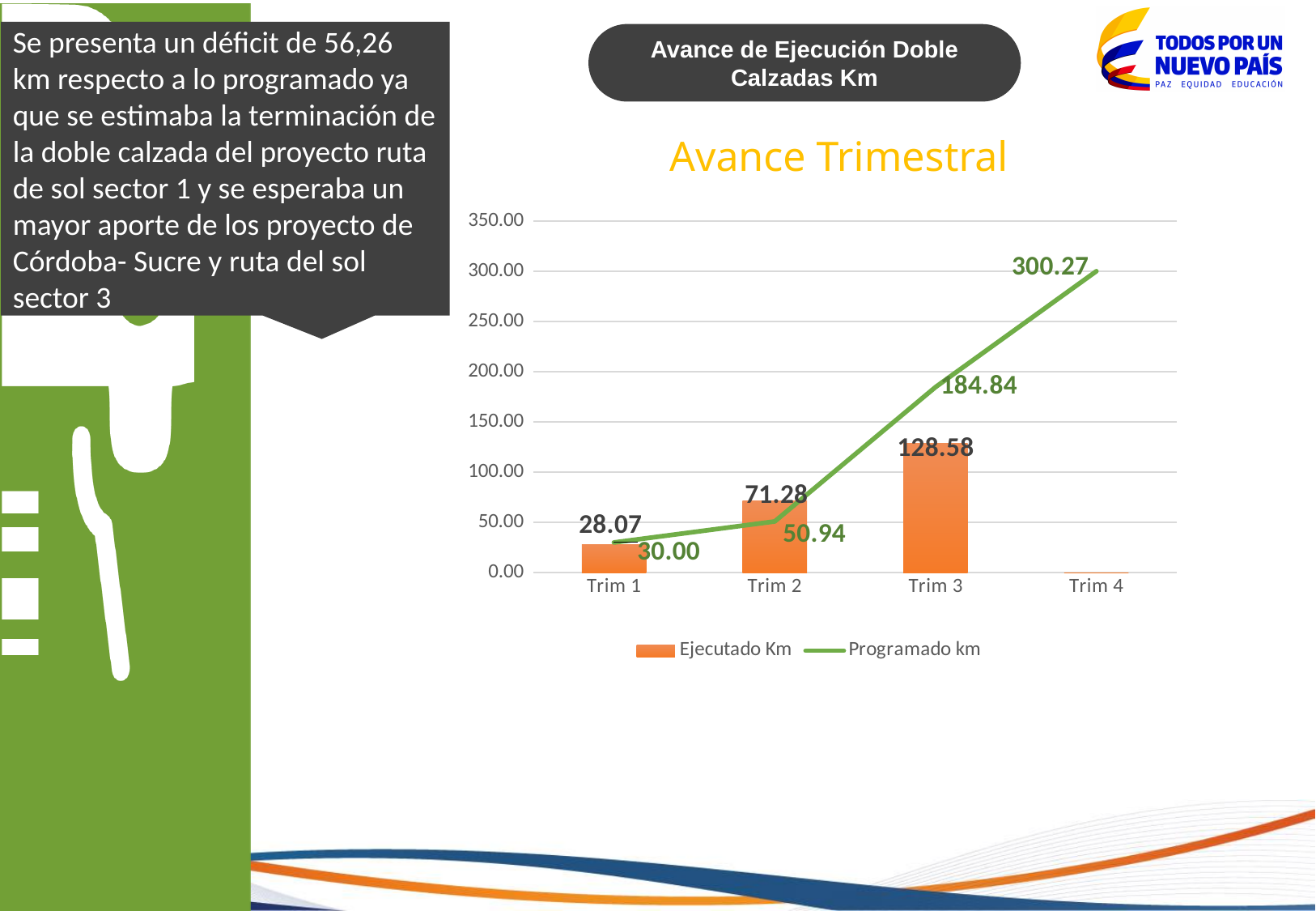
How many series does the legend list? 2 What is the title of the chart? Avance Trimestral Does the Programado km line rise or fall from Trim 1 to Trim 4? rise Is the Programado km value for Trim 3 greater or less than 150.00? greater What is the Ejecutado Km value for Trim 1? 28.07 Which quarter has the lowest Ejecutado Km value among the bars shown? Trim 1 What is the difference between Programado km and Ejecutado Km in Trim 3? 56.26 Which quarter has the highest Programado km value? Trim 4 What is the Programado km value for Trim 2? 50.94 What is the Programado km value for Trim 4? 300.27 In Trim 2, which is larger: Ejecutado Km or Programado km? Ejecutado Km What is the Ejecutado Km value for Trim 3? 128.58